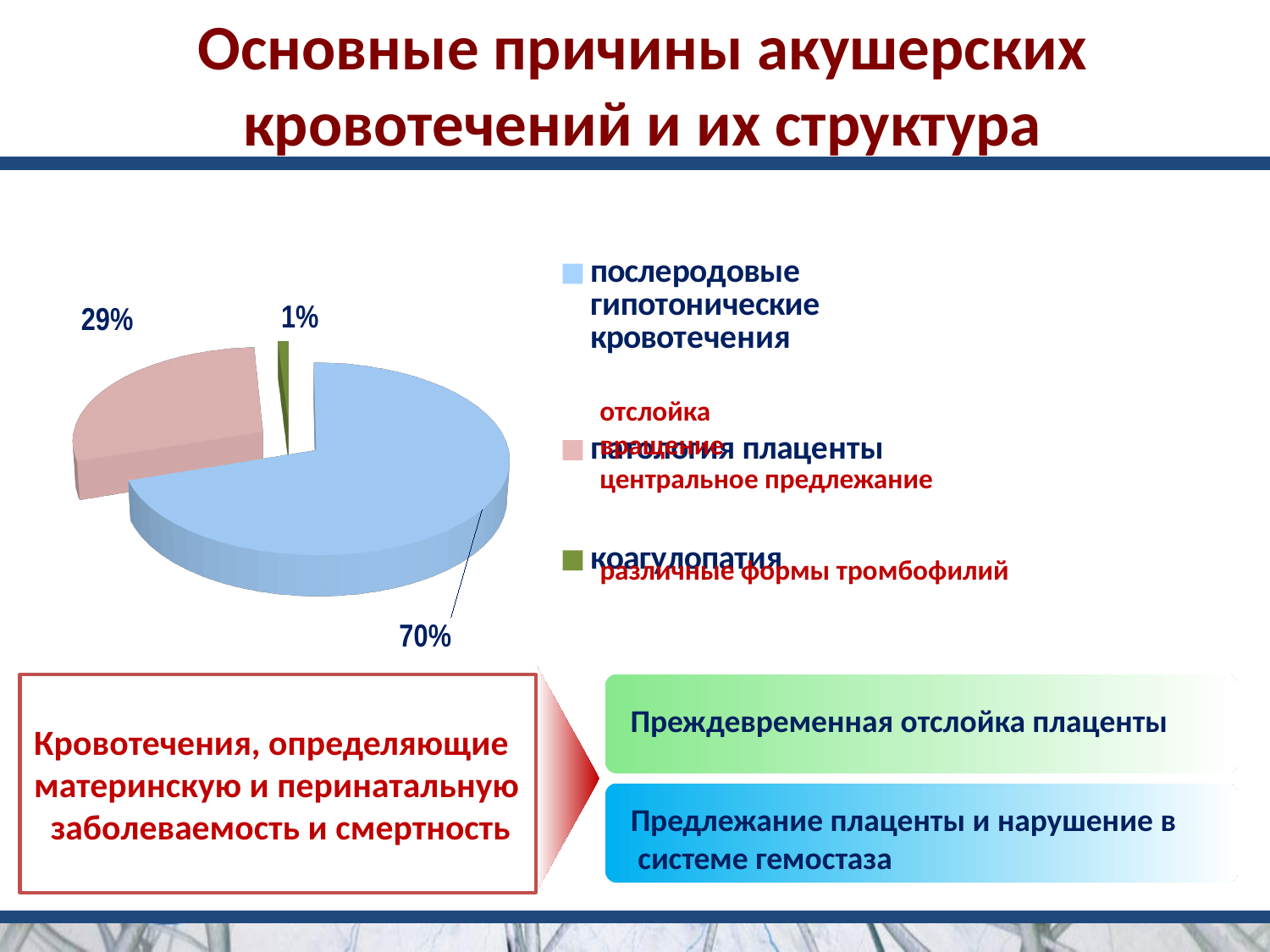
What share of the pie is labelled for коагулопатия? 1% Which category has the largest slice of the pie? послеродовые гипотонические кровотечения What colour is the slice for коагулопатия? green What is the difference in percentage points between the slices for патология плаценты and коагулопатия? 28 What share of the pie is labelled for послеродовые гипотонические кровотечения? 70% Which category has the smallest slice of the pie? коагулопатия How many slices does the pie chart have? 3 What share of the pie is labelled for патология плаценты? 29% How many entries does the chart legend list? 3 What is the difference in percentage points between the slices for послеродовые гипотонические кровотечения and патология плаценты? 41 Which slice is larger: патология плаценты or коагулопатия? патология плаценты What type of chart is shown on the slide? pie chart